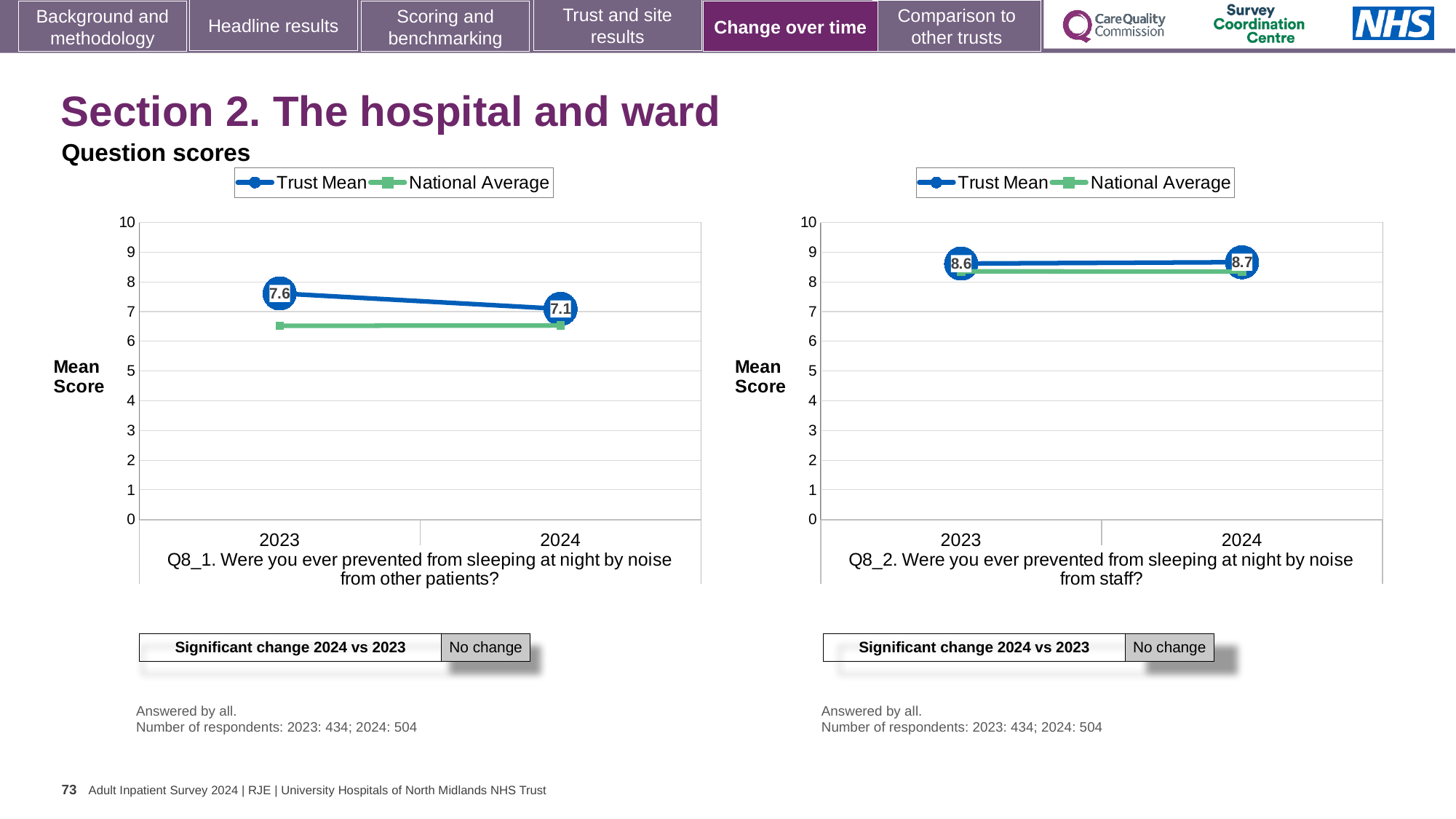
In the left chart (Q8_1), does the Trust Mean rise or fall from 2023 to 2024? fall In the left chart (Q8_1, noise from other patients), what is the Trust Mean for 2024? 7.1 How many years are shown on the x axis of the left chart (Q8_1)? 2 In the right chart (Q8_2, noise from staff), what is the Trust Mean for 2023? 8.6 In the right chart (Q8_2, noise from staff), what is the Trust Mean for 2024? 8.7 In the right chart (Q8_2), does the Trust Mean rise or fall from 2023 to 2024? rise What kind of chart is the left chart (Q8_1)? line chart In the left chart (Q8_1), by how much did the Trust Mean change from 2023 to 2024? 0.5 In the left chart (Q8_1, noise from other patients), what is the Trust Mean for 2023? 7.6 In the left chart (Q8_1), is the National Average for 2024 greater or less than 7? less In the left chart (Q8_1), which is larger for 2023: the Trust Mean or the National Average? Trust Mean How many series does the legend of the right chart (Q8_2) list? 2